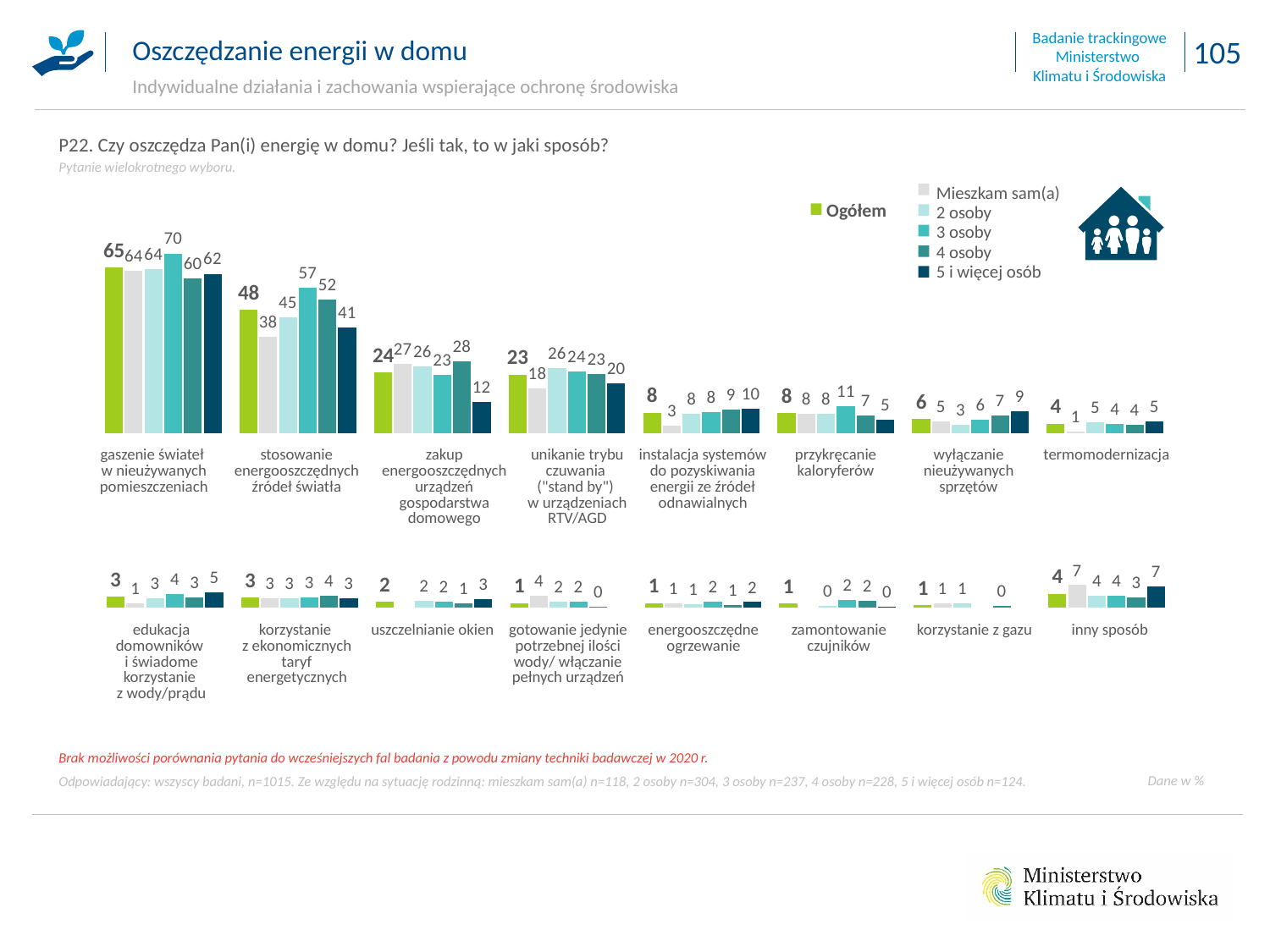
What kind of chart is shown on the slide? bar chart How many series does the legend list? 6 What is the value for '3 osoby' in the category 'stosowanie energooszczędnych źródeł światła'? 57 What is the Ogółem value for 'gaszenie świateł w nieużywanych pomieszczeniach'? 65 In the category 'zakup energooszczędnych urządzeń gospodarstwa domowego', which is larger: the value for '4 osoby' or for '5 i więcej osób'? 4 osoby What is the difference between the Ogółem values for 'gaszenie świateł w nieużywanych pomieszczeniach' and 'stosowanie energooszczędnych źródeł światła'? 17 Which category has the highest Ogółem value? gaszenie świateł w nieużywanych pomieszczeniach In the category 'gaszenie świateł w nieużywanych pomieszczeniach', what is the difference between the values for '3 osoby' and '4 osoby'? 10 What is the value for 'Mieszkam sam(a)' in the category 'termomodernizacja'? 1 What is the value for '5 i więcej osób' in the category 'wyłączanie nieużywanych sprzętów'? 9 What is the Ogółem value for 'inny sposób'? 4 What is the value for 'Mieszkam sam(a)' in the category 'instalacja systemów do pozyskiwania energii ze źródeł odnawialnych'? 3